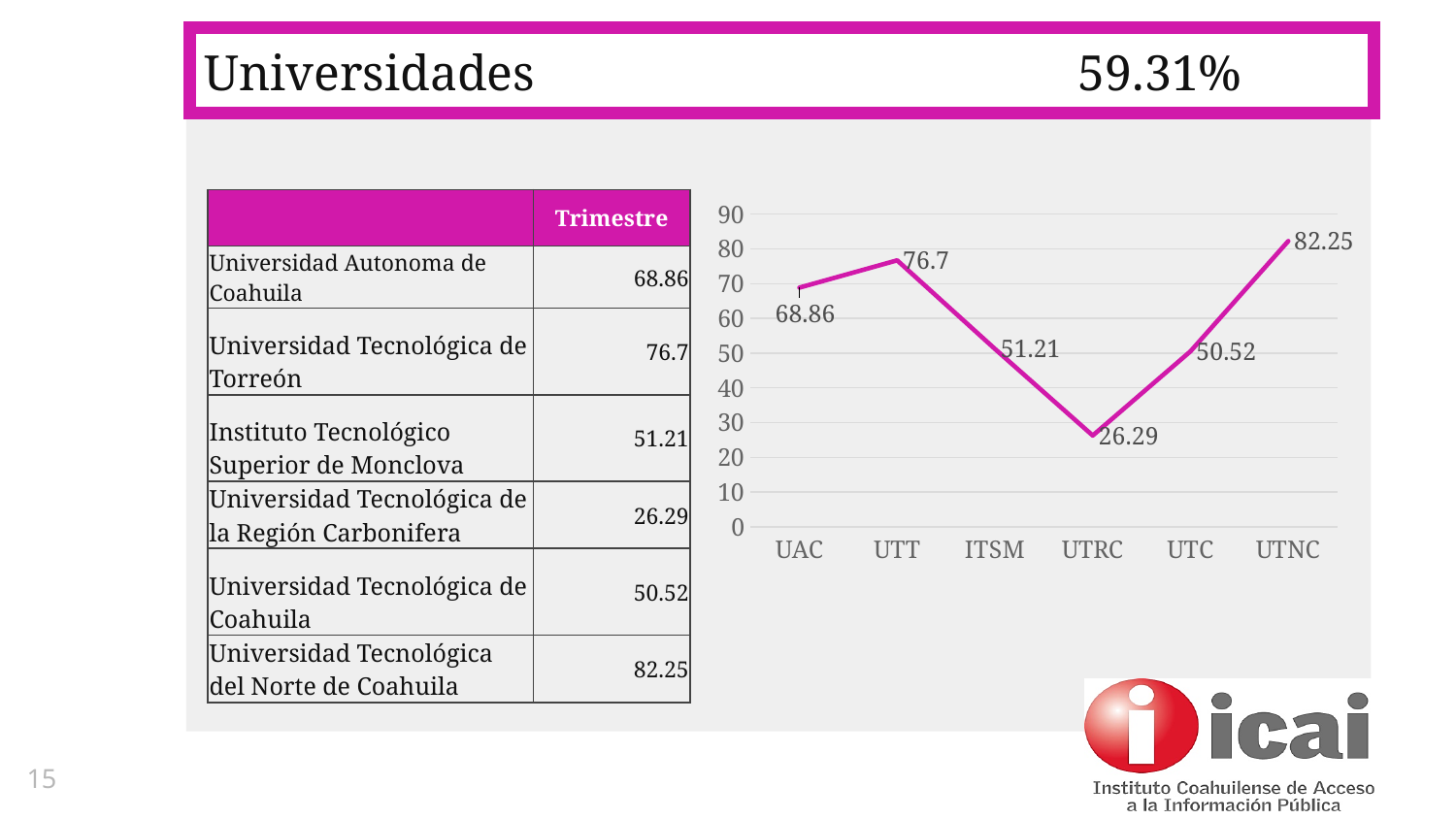
How many categories are plotted on the x axis of the chart? 6 What is the value for UTNC in the chart? 82.25 What is the value for UTRC in the chart? 26.29 Is the value for ITSM greater or less than 60? less What kind of chart is shown on the slide? line chart Which is larger, the value for UAC or the value for UTC? UAC Which category has the lowest value in the chart? UTRC Does the line rise or fall from UTRC to UTNC? rise What is the difference between the values for UTNC and UTRC? 55.96 What is the value for UTT in the chart? 76.7 Which category has the highest value in the chart? UTNC What is the difference between the values for UTT and UAC? 7.84